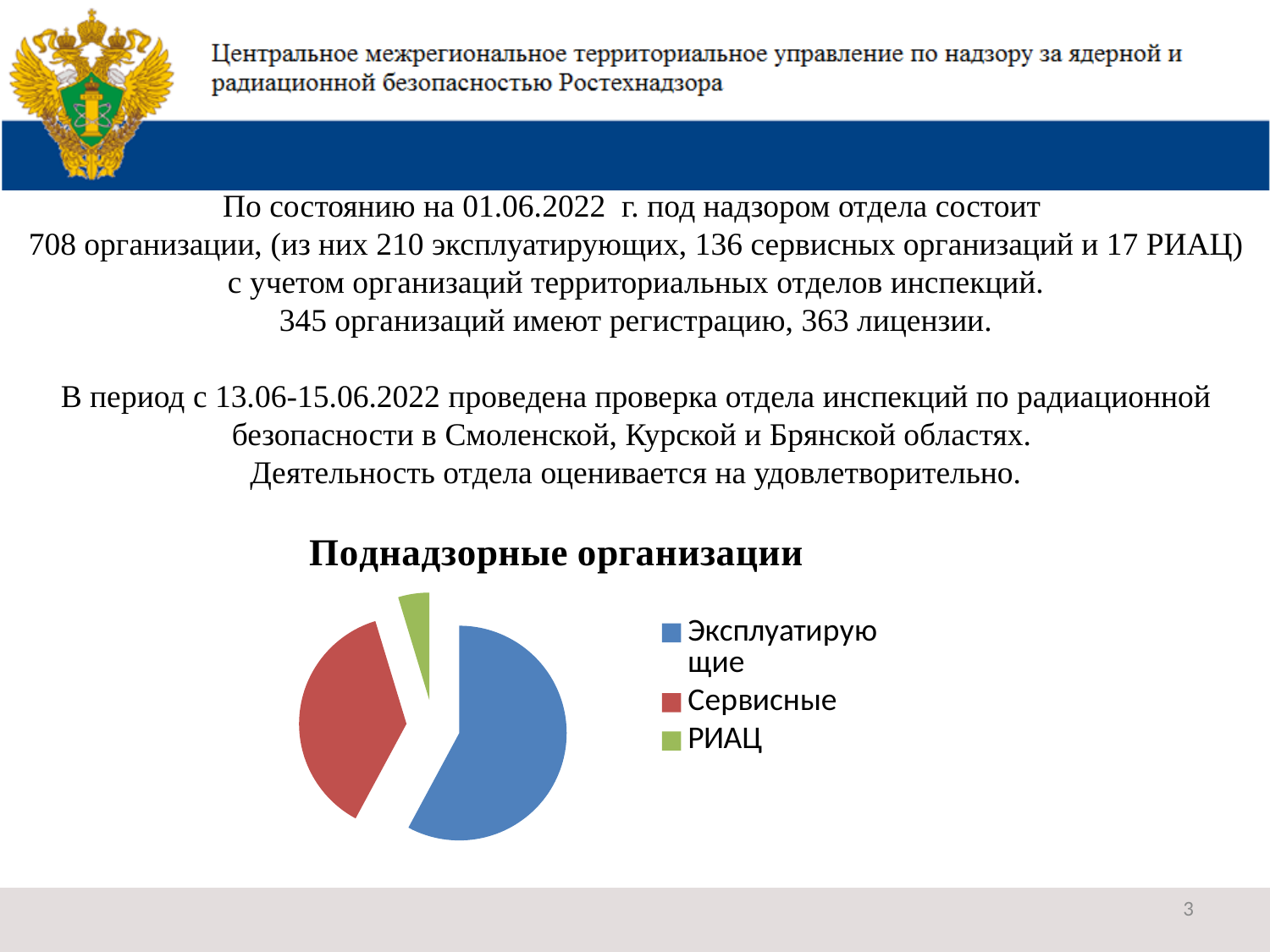
How many slices does the pie chart have? 3 Which slice is larger in the pie chart, Эксплуатирующие or Сервисные? Эксплуатирующие Which category has the largest slice in the pie chart? Эксплуатирующие What kind of chart is shown under the title "Поднадзорные организации"? pie chart Which slice is larger in the pie chart, Сервисные or РИАЦ? Сервисные How many entries does the legend of the pie chart list? 3 What is the title of the chart on the slide? Поднадзорные организации What colour is the slice for Сервисные in the pie chart? red Which category has the smallest slice in the pie chart? РИАЦ Which category is shown in green in the pie chart? РИАЦ